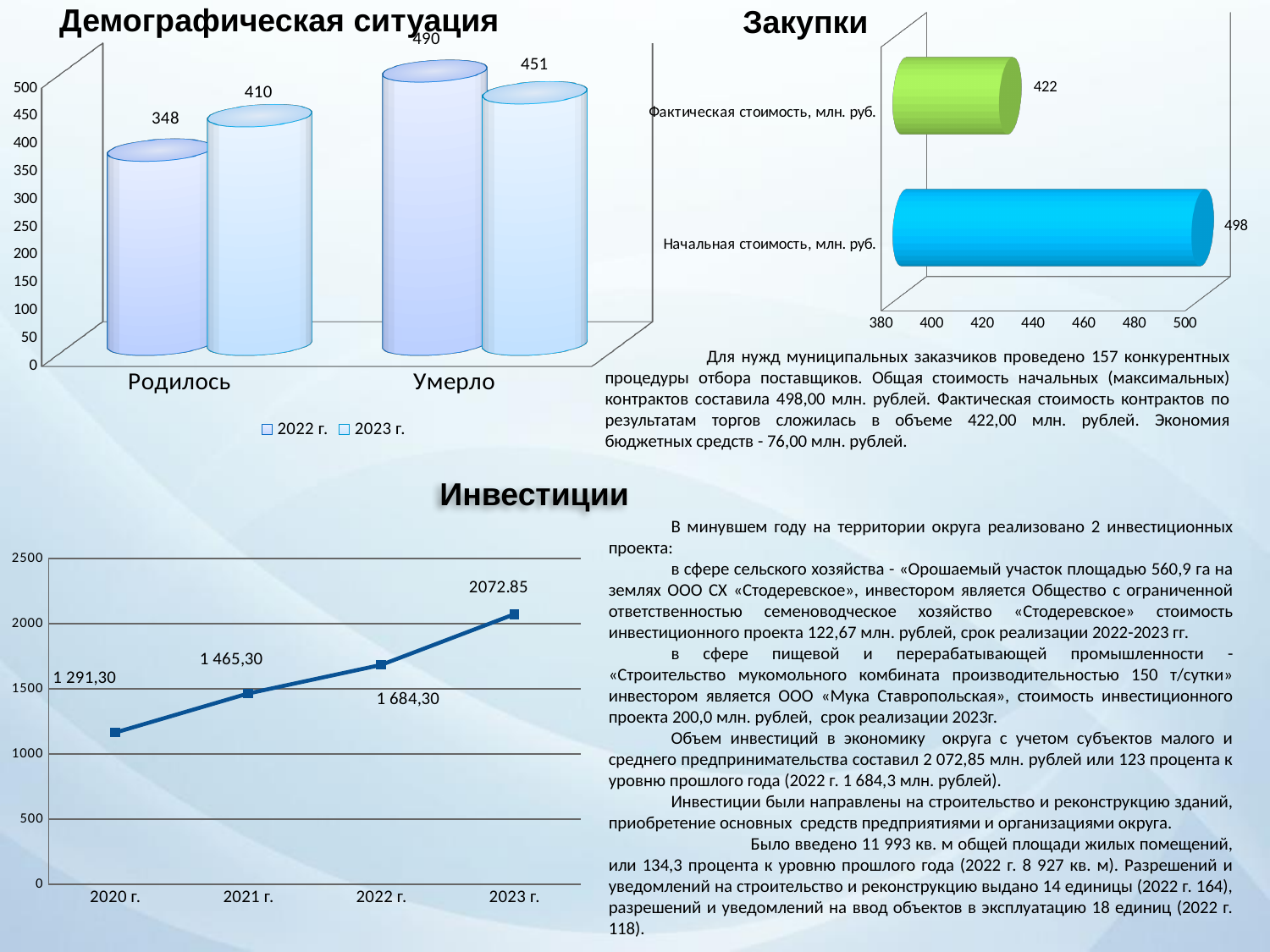
In the 'Демографическая ситуация' chart, what is the value for Умерло in 2023 г.? 451 In the 'Инвестиции' chart, which year has the highest value? 2023 г. In the 'Демографическая ситуация' chart, what is the value for Родилось in 2022 г.? 348 In the 'Инвестиции' chart, do the values rise or fall from 2020 г. to 2023 г.? rise In the 'Демографическая ситуация' chart, which is larger for 2023 г.: Родилось or Умерло? Умерло In the 'Инвестиции' chart, what is the value for 2021 г.? 1 465,30 How many series does the legend of the 'Демографическая ситуация' chart list? 2 In the 'Демографическая ситуация' chart, what is the difference between Умерло and Родилось in 2022 г.? 142 How many data points are plotted in the 'Инвестиции' chart? 4 In the 'Закупки' chart, what is the value for Начальная стоимость, млн. руб.? 498 What kind of chart is the 'Закупки' chart? bar chart In the 'Закупки' chart, what is the difference between Начальная стоимость and Фактическая стоимость? 76